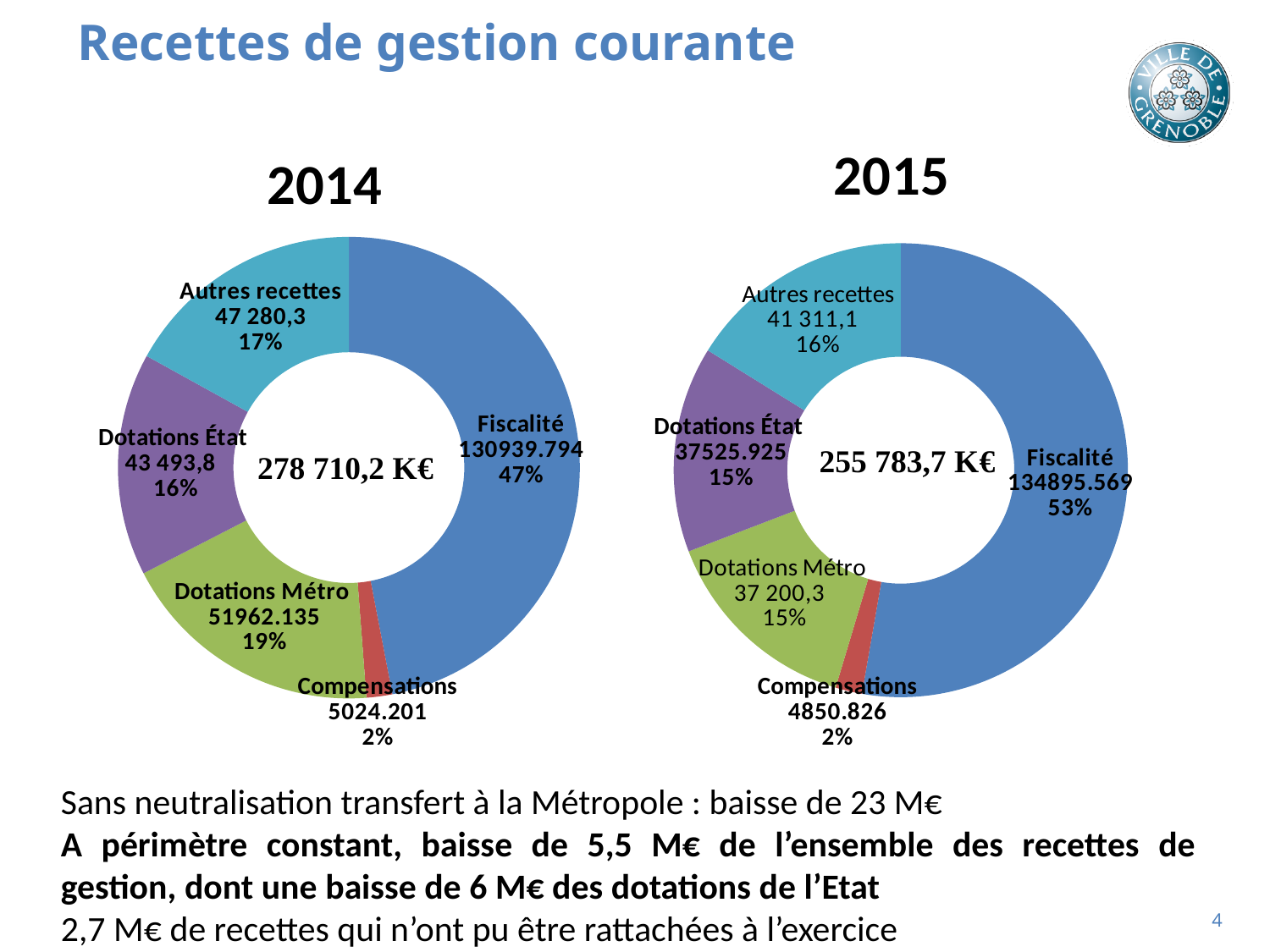
In the 2015 chart, what is the value shown for Compensations? 4850.826 In the 2014 chart, which category has the smallest slice? Compensations In the 2015 chart, which category has the largest slice? Fiscalité In the 2015 chart, what share of the pie does Fiscalité represent? 53% In the 2014 chart, what share of the pie does Fiscalité represent? 47% In the 2014 chart, what is the value shown for Dotations Métro? 51962.135 In the 2014 chart, what share of the pie does Autres recettes represent? 17% What total is printed in the centre of the 2015 chart? 255 783,7 K€ In the 2014 chart, which is larger: Dotations Métro or Dotations État? Dotations Métro In the 2015 chart, what is the value shown for Autres recettes? 41 311,1 What kind of chart is used for 2014? Pie chart (donut) How many categories are shown in the 2015 chart? 5